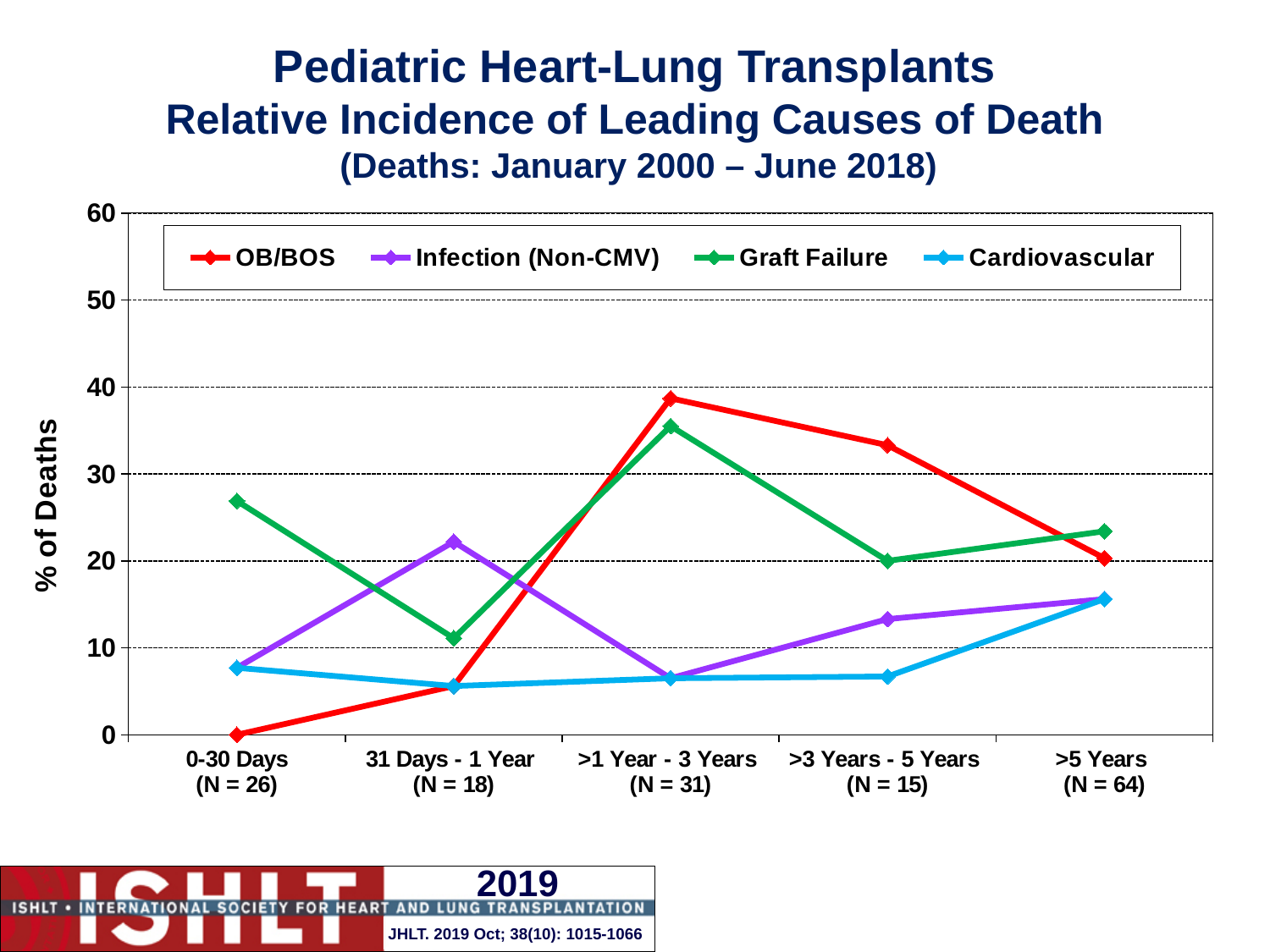
What is the value for OB/BOS at 0-30 Days? 0 Is the value for Graft Failure at 0-30 Days greater or less than 20? greater Which series has the highest value at 0-30 Days? Graft Failure Does the OB/BOS line rise or fall from >1 Year - 3 Years to >5 Years? Fall At which time period does OB/BOS reach its highest value? >1 Year - 3 Years What colour is the OB/BOS line in the legend? Red How many time-period categories are shown on the x axis? 5 Which series has the lowest value at 0-30 Days? OB/BOS How many series does the legend list? 4 Which is larger at 0-30 Days: Graft Failure or Cardiovascular? Graft Failure What kind of chart is shown on the slide? Line chart Is the value for Cardiovascular at >1 Year - 3 Years greater or less than 10? less